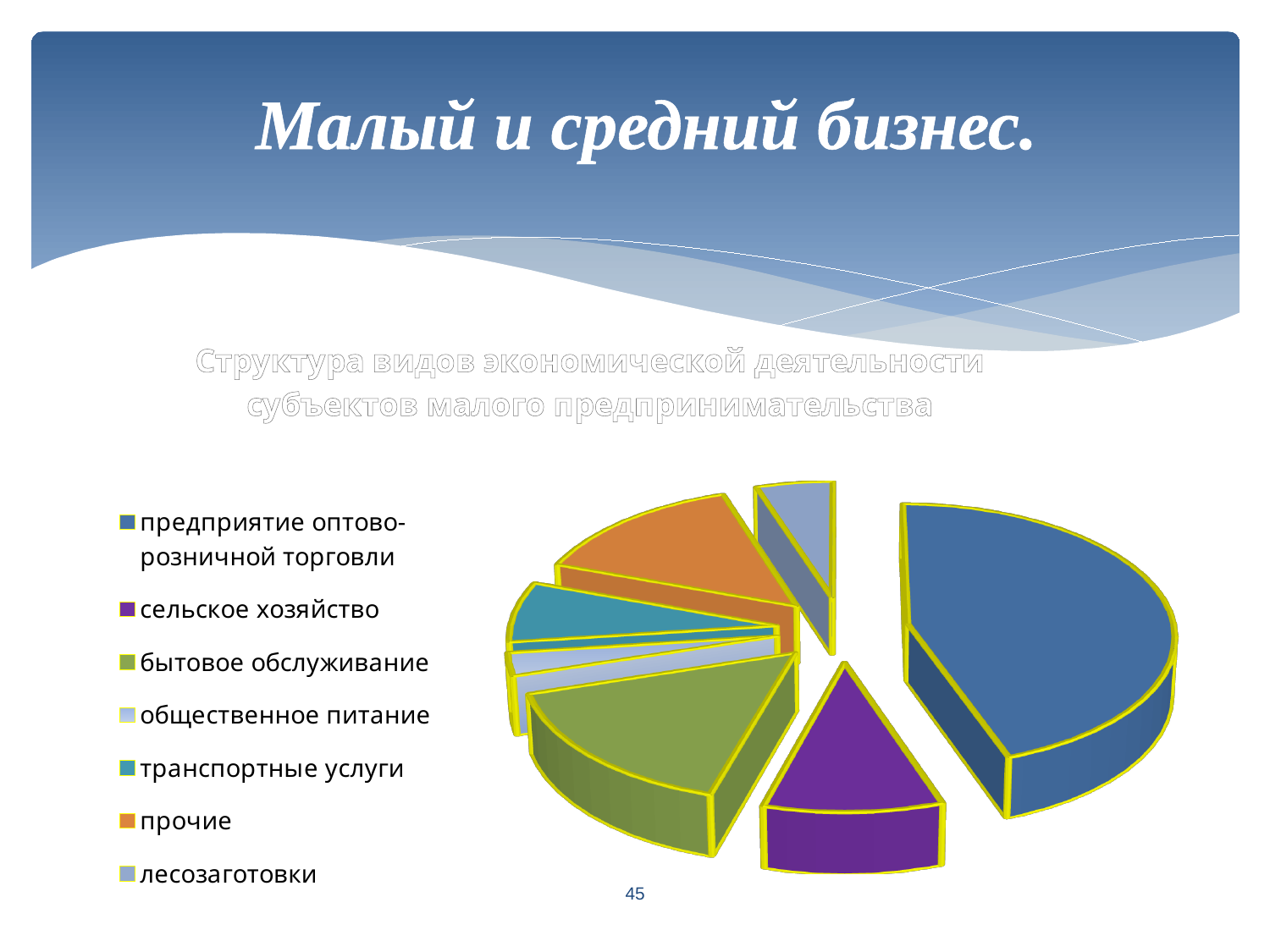
What is the title of the pie chart? Структура видов экономической деятельности субъектов малого предпринимательства Which category has the smallest slice of the pie chart? общественное питание Which slice is larger: лесозаготовки or общественное питание? лесозаготовки What colour is the slice for сельское хозяйство in the pie chart? purple How many categories does the legend of the pie chart list? 7 Which slice is larger: предприятие оптово-розничной торговли or сельское хозяйство? предприятие оптово-розничной торговли Which category has the largest slice of the pie chart? предприятие оптово-розничной торговли Which slice is larger: прочие or транспортные услуги? прочие What kind of chart is shown on the slide? pie chart